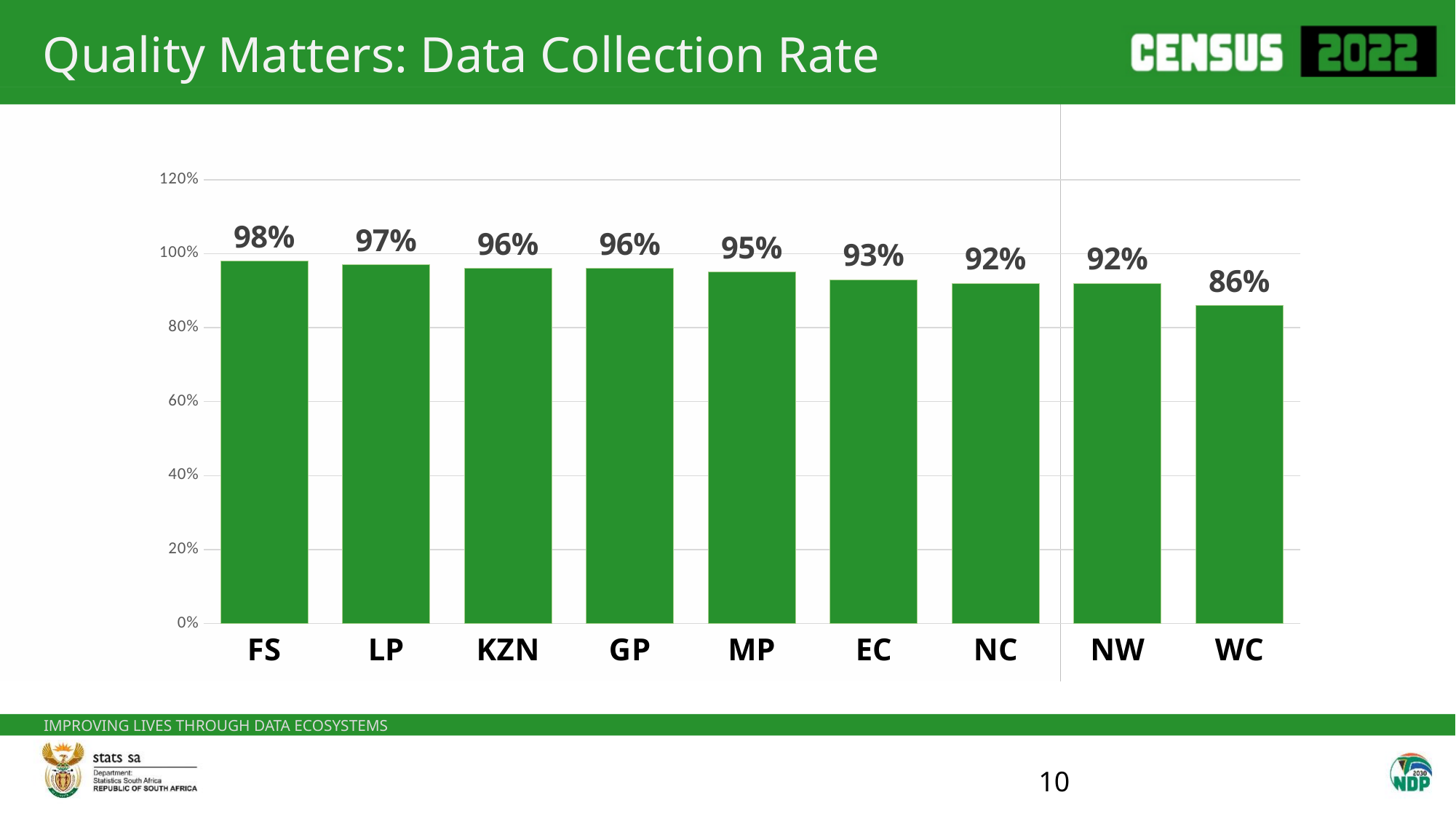
Which province has the highest data collection rate? FS What is the data collection rate for FS? 98% What is the data collection rate for WC? 86% What is the data collection rate for EC? 93% How many provinces are shown in the chart? 9 What is the difference between the data collection rates of FS and WC? 12% What kind of chart is shown on the slide? Bar chart Which province has the lowest data collection rate? WC Do the data collection rates generally rise or fall from FS to WC along the x axis? Fall Which has a higher data collection rate, KZN or NC? KZN What is the difference between the data collection rates of LP and EC? 4% What is the data collection rate for MP? 95%